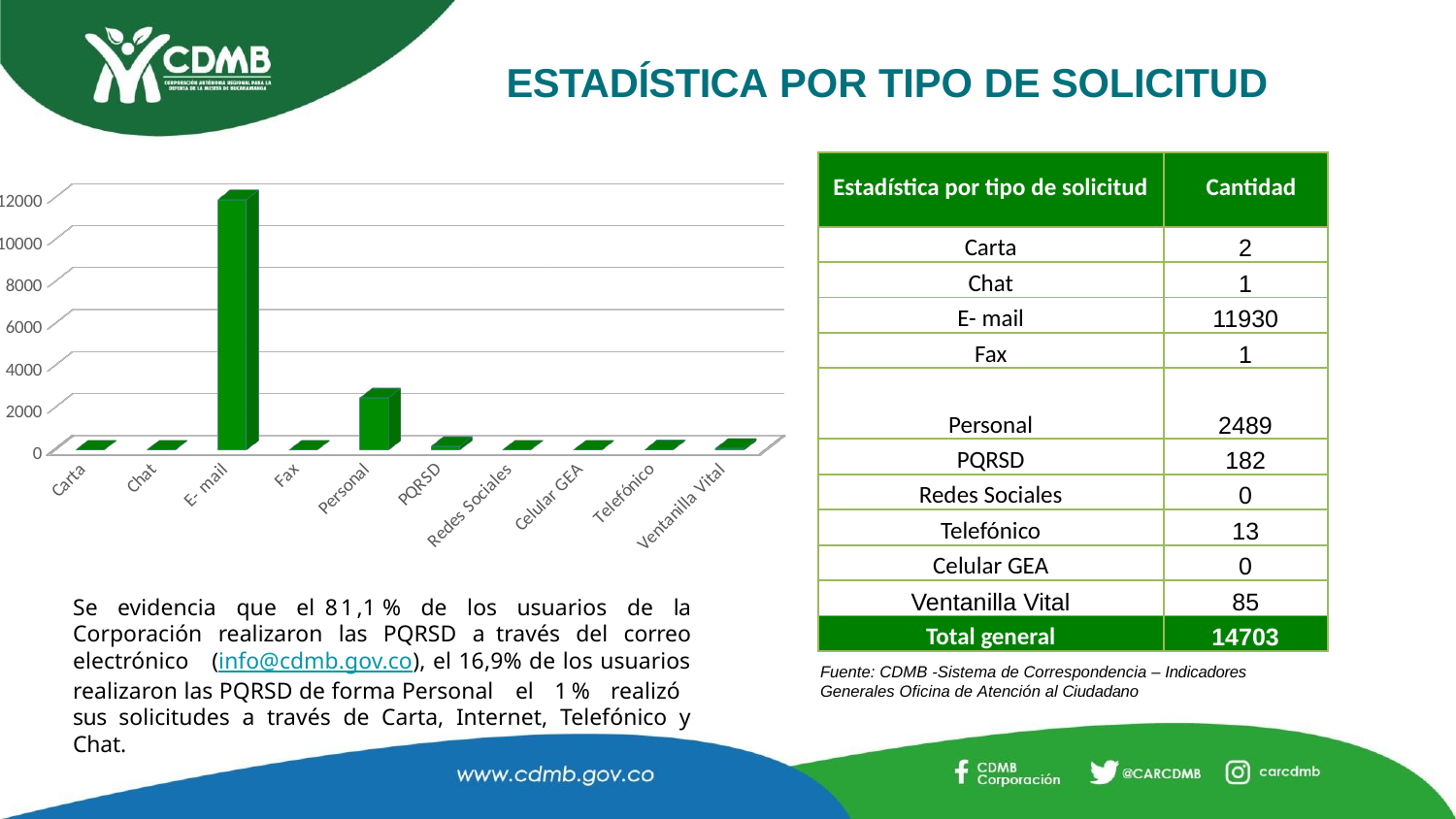
What kind of chart is shown on the slide? bar chart What is the difference between the values for E- mail and Personal shown in the table? 9441 Is the value for E- mail greater or less than 10000? greater How many categories are shown on the x axis of the chart? 10 Is the value for PQRSD greater or less than 2000? less Which is larger, the value for Personal or the value for Ventanilla Vital? Personal Which is larger, the value for E- mail or the value for Personal? E- mail According to the table, what is the Cantidad for E- mail? 11930 According to the table, what is the Cantidad for Personal? 2489 Which category has the highest bar in the chart? E- mail Is the value for Personal greater or less than 2000? greater What is the highest tick value shown on the vertical axis of the chart? 12000